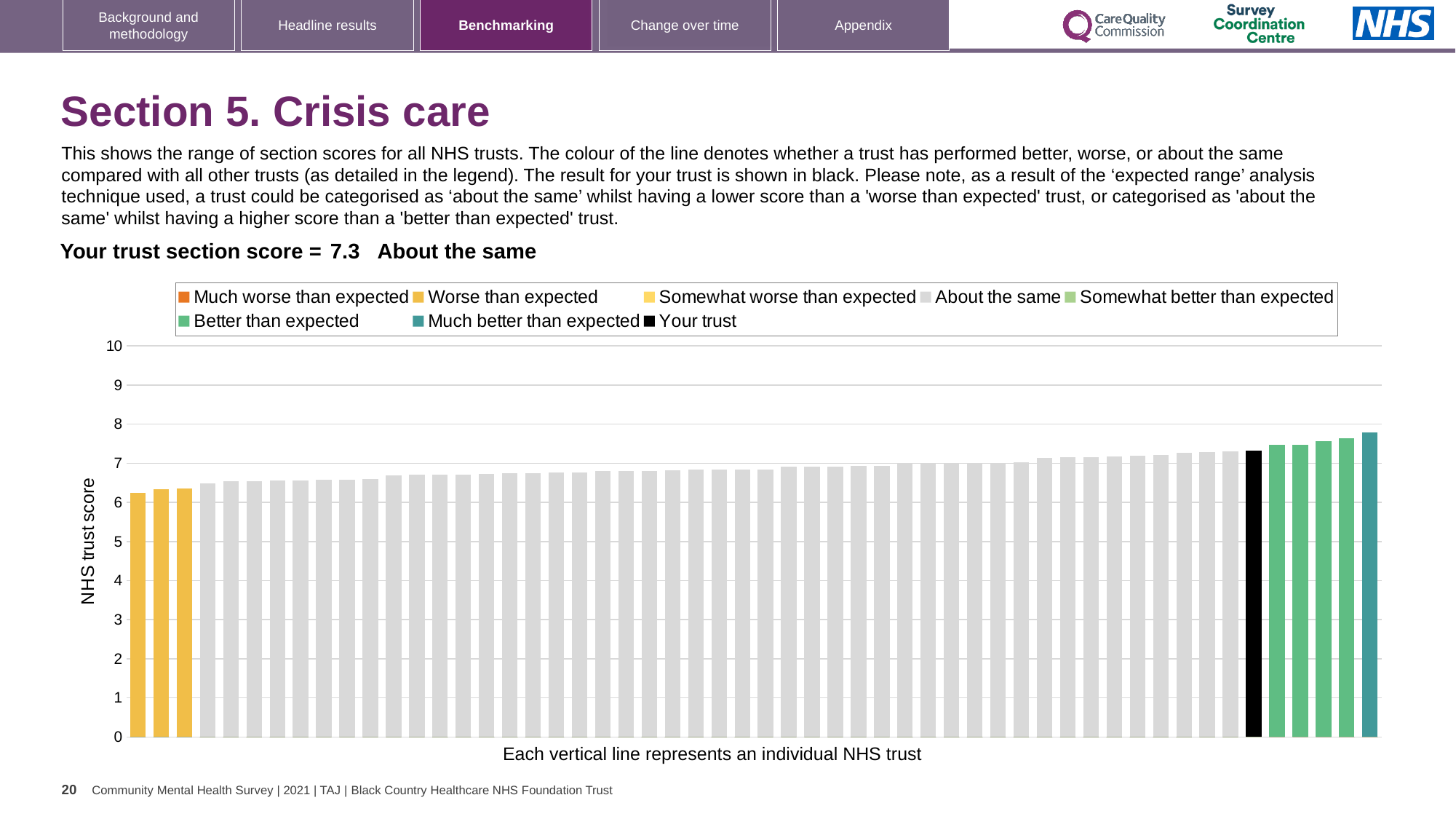
Do the bar values rise or fall from left to right along the x axis? rise What kind of chart is shown on the slide? bar chart What is the label on the vertical axis of the chart? NHS trust score How many bars are coloured as 'Worse than expected' (yellow)? 3 Is the value of the black 'Your trust' bar greater or less than 7? greater Which legend category does the tallest bar belong to? Much better than expected Which is larger: the value of the 'Your trust' bar or the value of the leftmost bar? Your trust Is the value of the tallest bar greater or less than 8? less Is the value of the leftmost bar greater or less than 7? less What is the section score for your trust shown on the slide? 7.3 How many bars are coloured as 'Better than expected' (green)? 4 How many entries does the chart legend list? 8